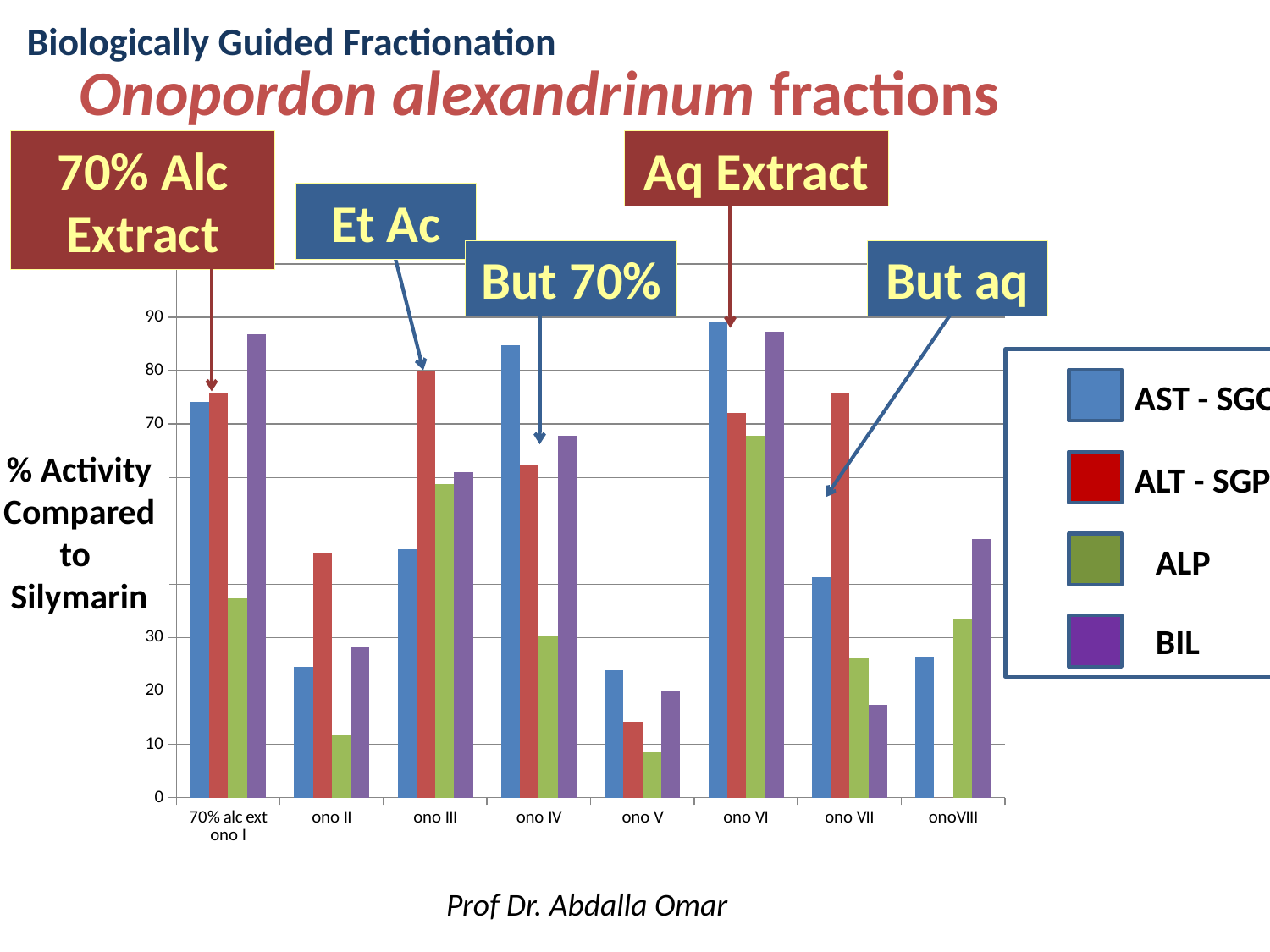
Which fraction has the lowest ALP value? ono V For ono VII, which is larger, the AST value or the ALT value? ALT Is the ALT value for ono III greater or less than 70? greater How many fraction categories are shown along the x axis? 8 Which fraction has the highest AST value? ono VI Which fraction has the highest ALP value? ono VI Is the ALT value for ono V greater or less than 20? less What kind of chart is shown on the slide? bar chart Is the AST value for ono VI greater or less than 80? greater What colour represents the BIL series in the legend? purple How many series does the legend list? 4